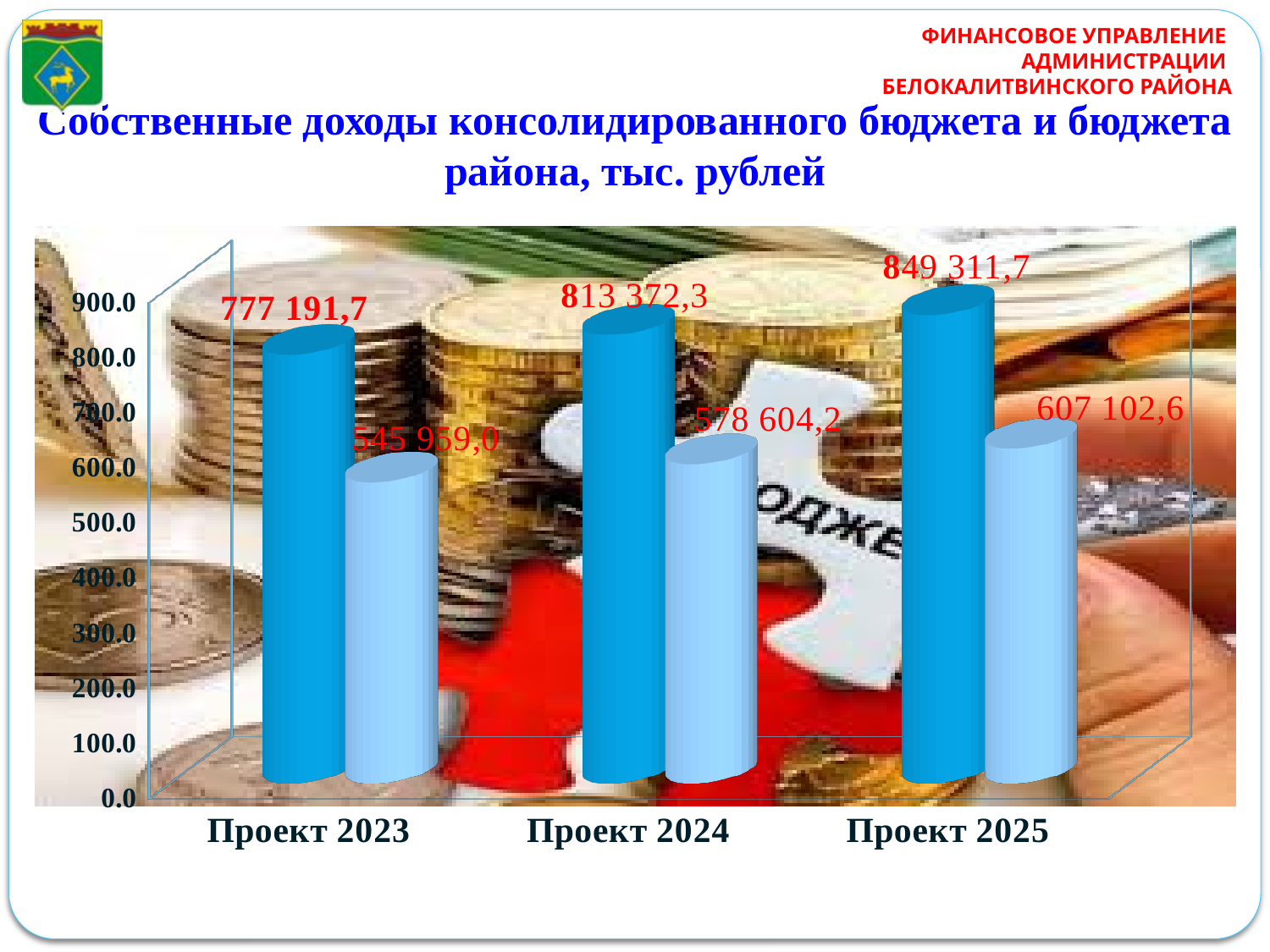
How many categories are shown on the x axis? 3 What is the value of the dark blue bar for Проект 2025? 849 311,7 What is the value of the light blue bar for Проект 2023? 545 959,0 Do the dark blue values rise or fall from Проект 2023 to Проект 2025? rise What is the value of the light blue bar for Проект 2024? 578 604,2 What is the value of the dark blue bar for Проект 2023? 777 191,7 Which category has the highest dark blue bar? Проект 2025 Is the light blue bar for Проект 2023 greater or less than 600.0 on the axis? less What is the difference between the dark blue and light blue values for Проект 2024? 234 768,1 Which category has the lowest light blue bar? Проект 2023 Which is larger: the light blue value for Проект 2025 or the light blue value for Проект 2024? Проект 2025 What is the difference between the dark blue values for Проект 2025 and Проект 2023? 72 120,0